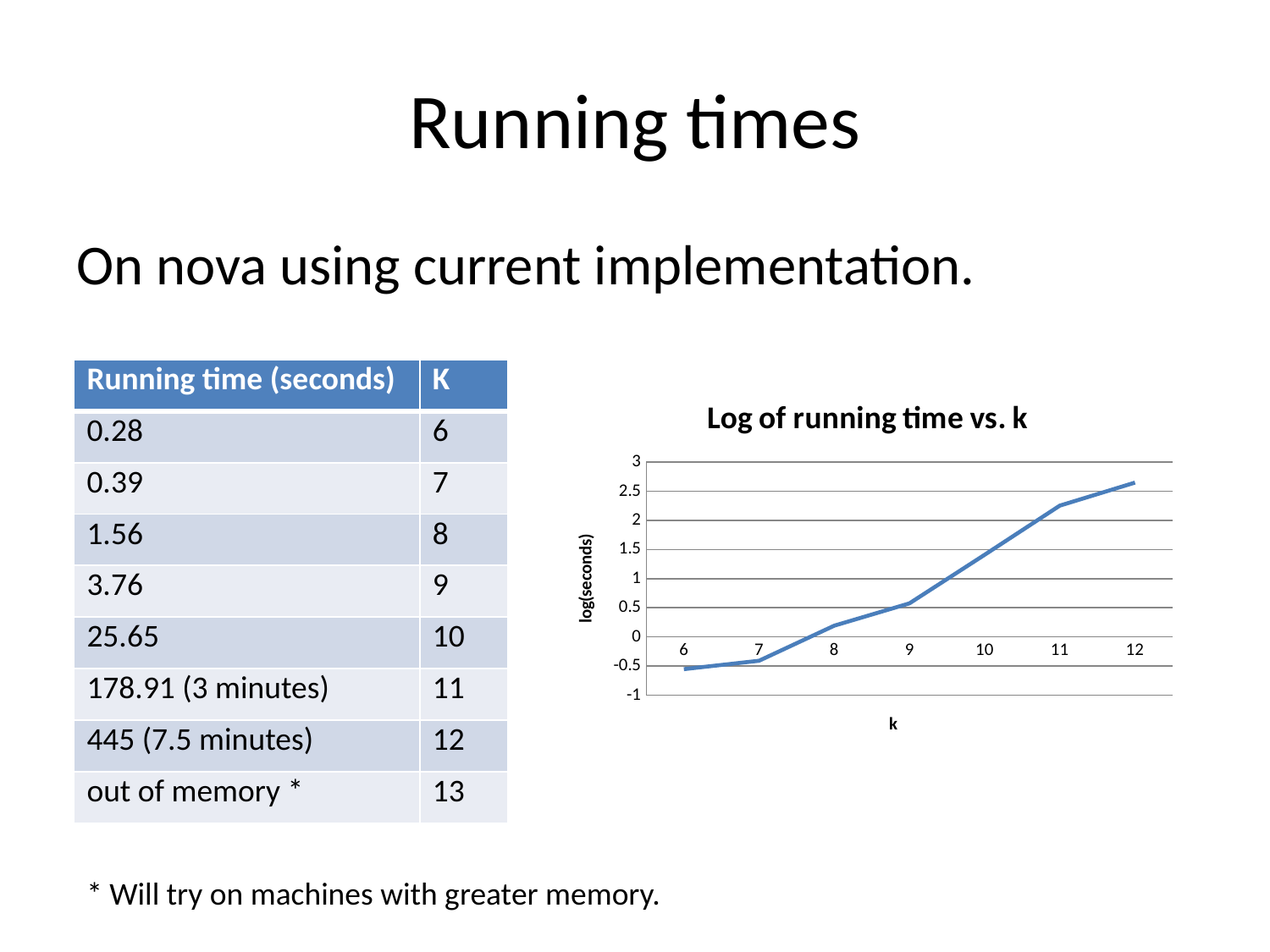
Is the plotted value for k = 10 greater or less than 1? greater Is the plotted value for k = 9 greater or less than 1? less At which value of k is the plotted log of running time lowest? 6 Is the plotted value for k = 6 greater or less than 0? less Which has the larger plotted log of running time, k = 8 or k = 11? k = 11 What is the title of the chart? Log of running time vs. k How many data points are plotted on the line in the chart? 7 What is the label of the vertical axis of the chart? log(seconds) At which value of k is the plotted log of running time highest? 12 What kind of chart is shown on the slide? line chart Does the plotted log of running time rise or fall as k increases from 6 to 12? rise